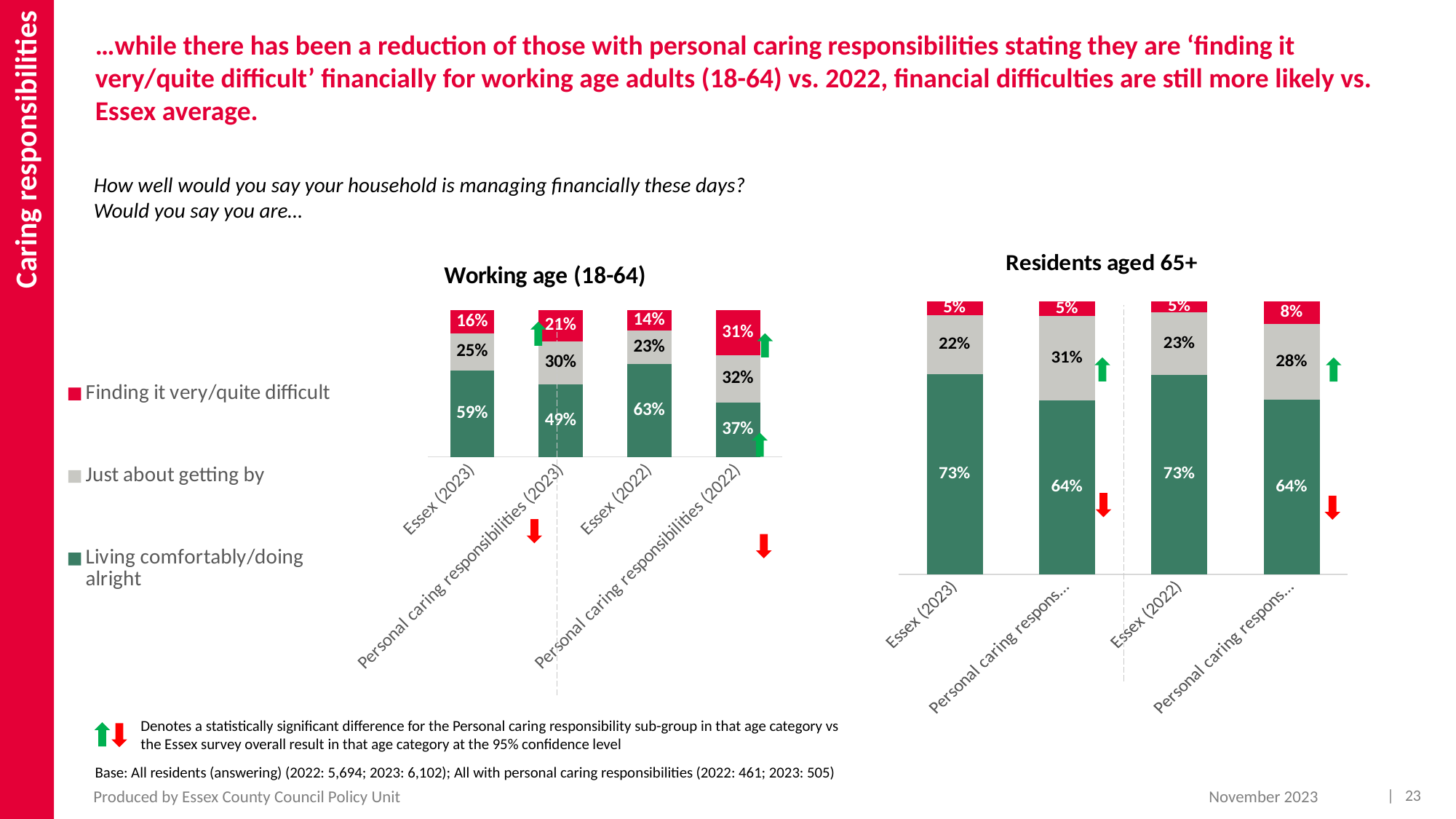
What type of chart is the 'Working age (18-64)' chart? Stacked bar chart In the 'Residents aged 65+' chart, what is the 'Finding it very/quite difficult' value for the rightmost bar (Personal caring responsibilities, 2022)? 8% In the 'Working age (18-64)' chart, what is the difference between the 'Living comfortably/doing alright' values for Essex (2022) and Personal caring responsibilities (2022)? 26 percentage points In the 'Working age (18-64)' chart, what percentage of Essex (2023) respondents are 'Finding it very/quite difficult'? 16% In the 'Working age (18-64)' chart, what percentage of Personal caring responsibilities (2023) respondents are 'Just about getting by'? 30% In the 'Working age (18-64)' chart, what percentage of Personal caring responsibilities (2022) respondents are 'Living comfortably/doing alright'? 37% How many series does the legend list? 3 In the 'Working age (18-64)' chart, which category has the lowest 'Living comfortably/doing alright' value? Personal caring responsibilities (2022) How many bars are shown in the 'Residents aged 65+' chart? 4 In the 'Residents aged 65+' chart, which is larger: the 'Just about getting by' value for Essex (2023) or for the second bar from the left (Personal caring responsibilities, 2023)? Personal caring responsibilities (2023) In the 'Working age (18-64)' chart, which category has the highest 'Finding it very/quite difficult' value? Personal caring responsibilities (2022) In the 'Residents aged 65+' chart, what percentage of Essex (2023) respondents are 'Living comfortably/doing alright'? 73%